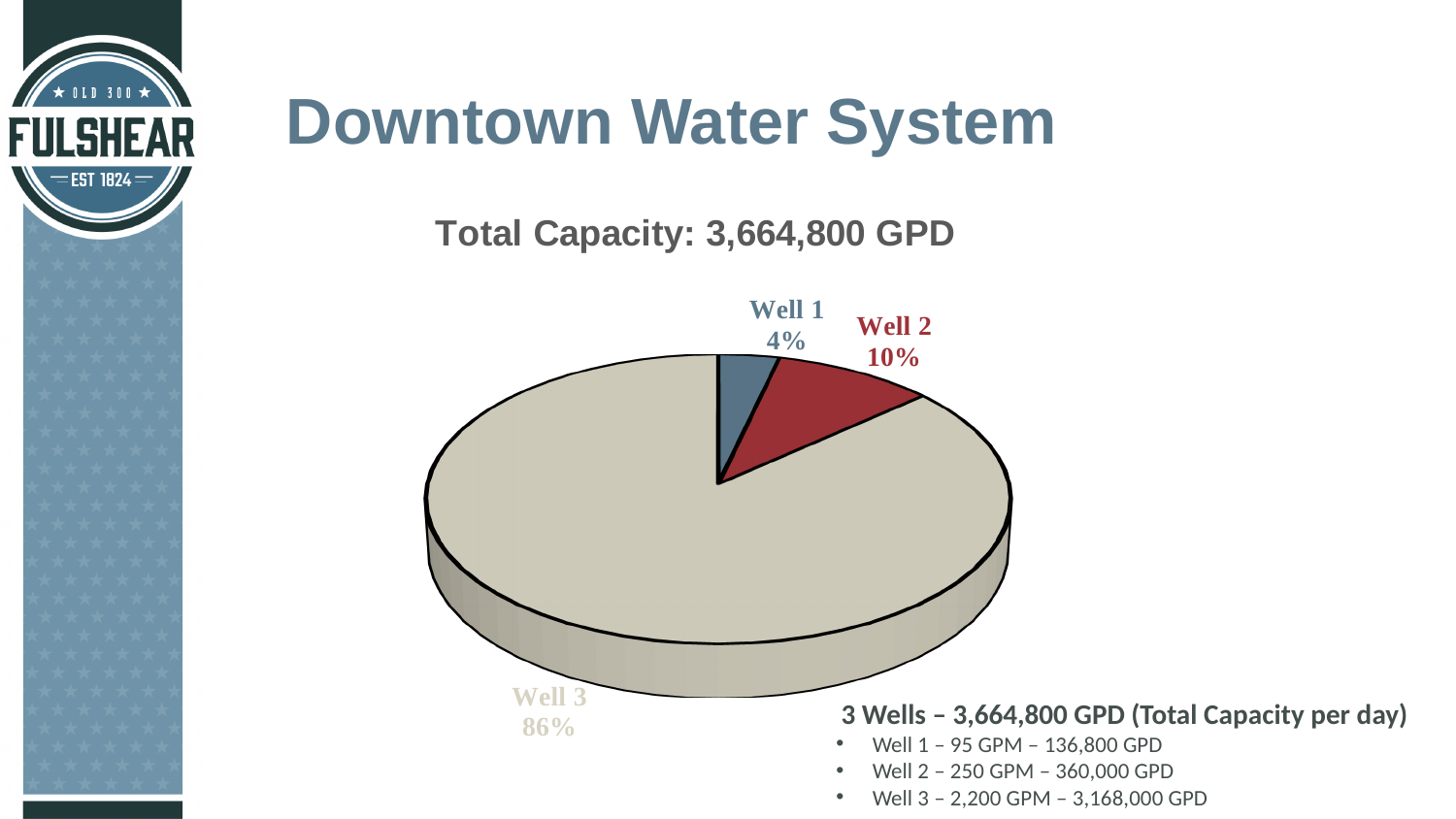
Which well has the largest slice of the pie? Well 3 What is the difference in percentage points between the Well 3 slice and the Well 2 slice? 76 What share of the pie does Well 1 represent? 4% What share of the pie does Well 2 represent? 10% Which well has the smallest slice of the pie? Well 1 What is the title shown above the pie chart? Total Capacity: 3,664,800 GPD How many slices does the pie chart have? 3 What is the difference in percentage points between the Well 2 slice and the Well 1 slice? 6 What kind of chart is shown on the slide? Pie chart Which slice is larger, Well 1 or Well 2? Well 2 What colour is the Well 2 slice of the pie? Red What share of the pie does Well 3 represent? 86%